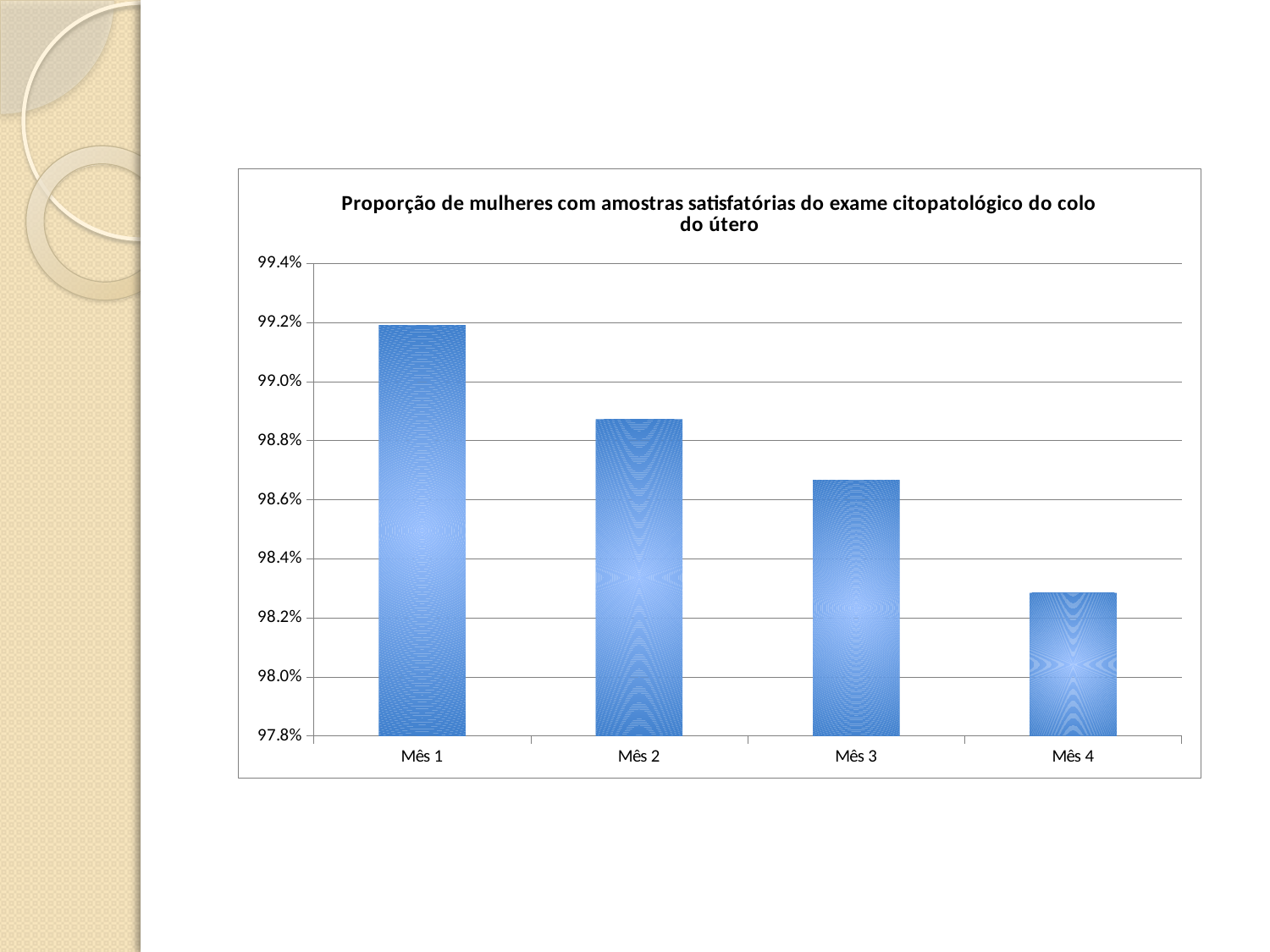
Is the value for Mês 3 greater or less than 98.8%? less Which month has the highest proportion? Mês 1 Is the value for Mês 4 greater or less than 98.4%? less Is the value for Mês 4 greater or less than 98.2%? greater How many months (categories) are plotted on the chart? 4 What is the title of the chart? Proporção de mulheres com amostras satisfatórias do exame citopatológico do colo do útero Do the values rise or fall from Mês 1 to Mês 4? fall Which month has the lowest proportion? Mês 4 What kind of chart is shown on the slide? bar chart Which is larger, the value for Mês 2 or the value for Mês 3? Mês 2